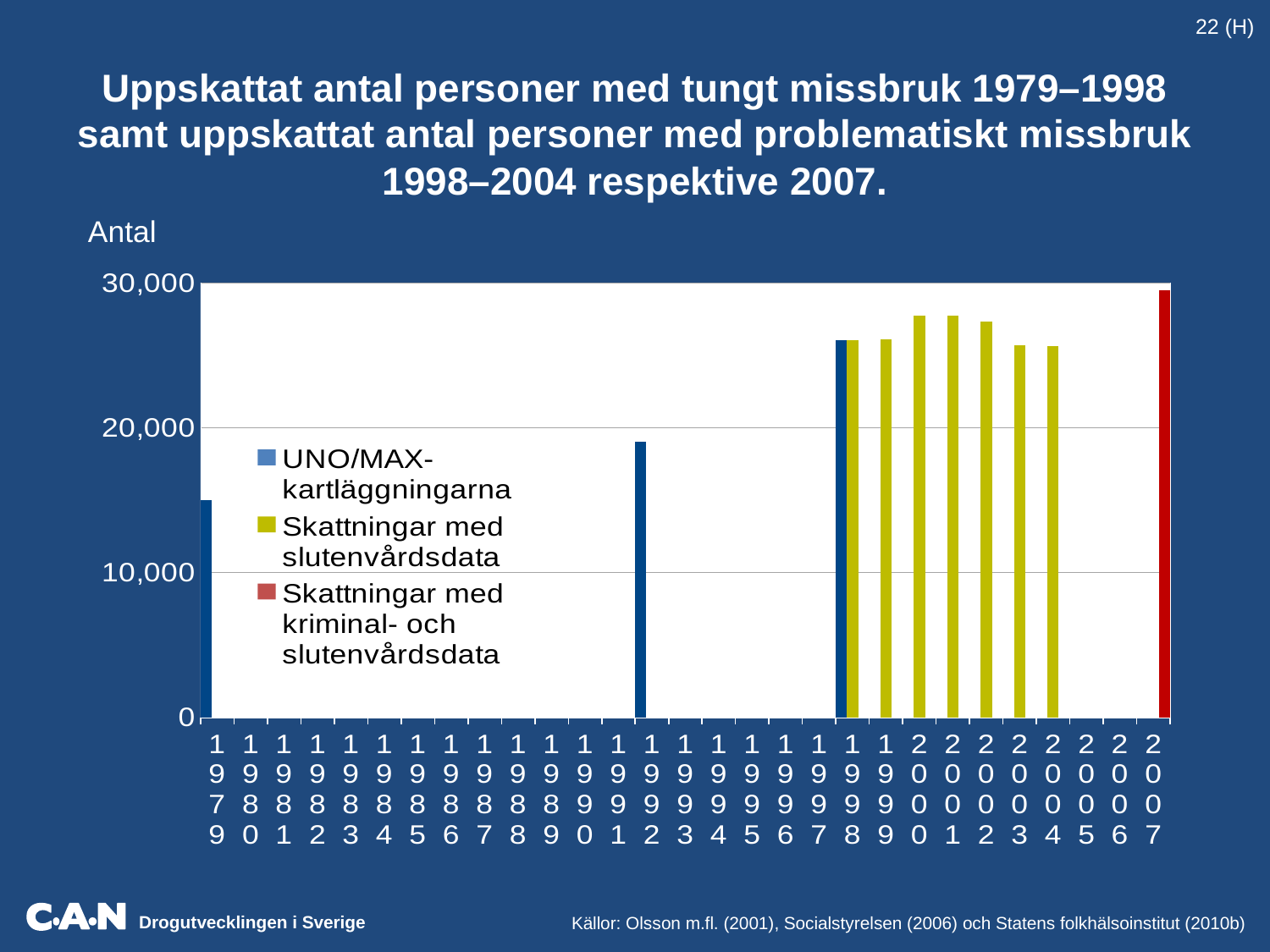
Is the UNO/MAX-kartläggningarna value for 1979 greater or less than 10,000? greater How many series does the legend list? 3 Which series is shown in red in the legend? Skattningar med kriminal- och slutenvårdsdata What kind of chart is shown on the slide? bar chart Do the UNO/MAX-kartläggningarna values rise or fall from 1979 to 1998? rise Is the Skattningar med kriminal- och slutenvårdsdata value for 2007 greater or less than 20,000? greater Which year has the highest bar in the chart? 2007 How many years are labelled on the x axis? 29 How many bars are plotted for the series Skattningar med slutenvårdsdata? 7 Which is larger, the UNO/MAX-kartläggningarna value for 1979 or for 1992? 1992 What is the label on the vertical axis? Antal Is the UNO/MAX-kartläggningarna value for 1992 greater or less than 20,000? less